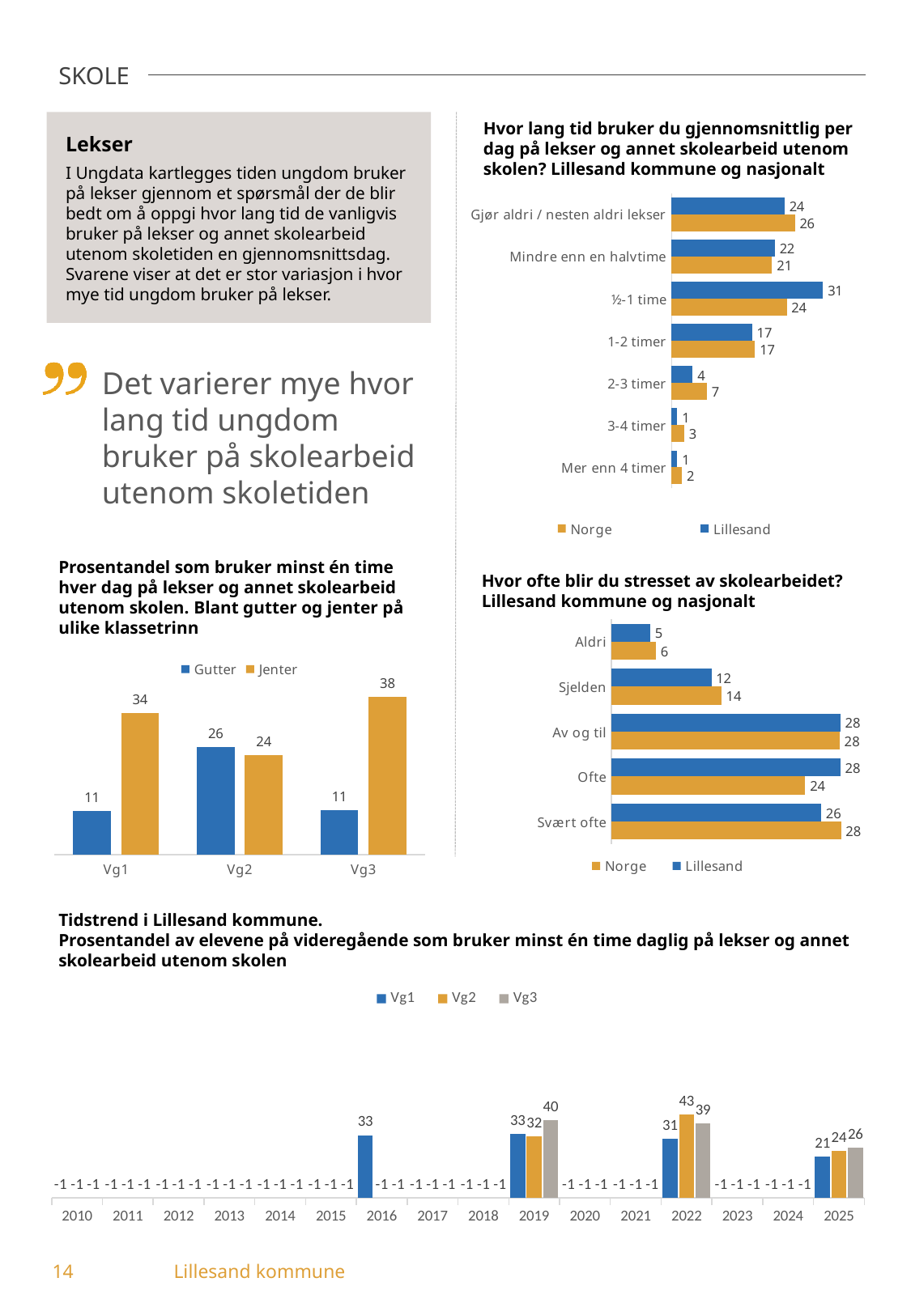
In the chart 'Hvor lang tid bruker du gjennomsnittlig per dag på lekser og annet skolearbeid utenom skolen?', which category has the highest value for Lillesand? ½-1 time In the chart 'Prosentandel som bruker minst én time hver dag på lekser og annet skolearbeid utenom skolen', what is the difference between Jenter and Gutter at Vg1? 23 In the chart 'Prosentandel som bruker minst én time hver dag på lekser og annet skolearbeid utenom skolen', which is larger at Vg2, Gutter or Jenter? Gutter In the chart 'Tidstrend i Lillesand kommune', what is the value for Vg2 in 2022? 43 In the chart 'Hvor ofte blir du stresset av skolearbeidet?', how many series does the legend list? 2 In the chart 'Hvor ofte blir du stresset av skolearbeidet?', what is the value for Lillesand for 'Sjelden'? 12 In the chart 'Hvor ofte blir du stresset av skolearbeidet?', which category has the lowest value for Norge? Aldri In the chart 'Tidstrend i Lillesand kommune', what kind of chart is it? Bar chart In the chart 'Hvor lang tid bruker du gjennomsnittlig per dag på lekser og annet skolearbeid utenom skolen?', what is the value for Lillesand for '½-1 time'? 31 In the chart 'Hvor lang tid bruker du gjennomsnittlig per dag på lekser og annet skolearbeid utenom skolen?', what is the value for Norge for '2-3 timer'? 7 In the chart 'Prosentandel som bruker minst én time hver dag på lekser og annet skolearbeid utenom skolen', what is the value for Jenter at Vg3? 38 In the chart 'Hvor lang tid bruker du gjennomsnittlig per dag på lekser og annet skolearbeid utenom skolen?', how many categories are shown? 7